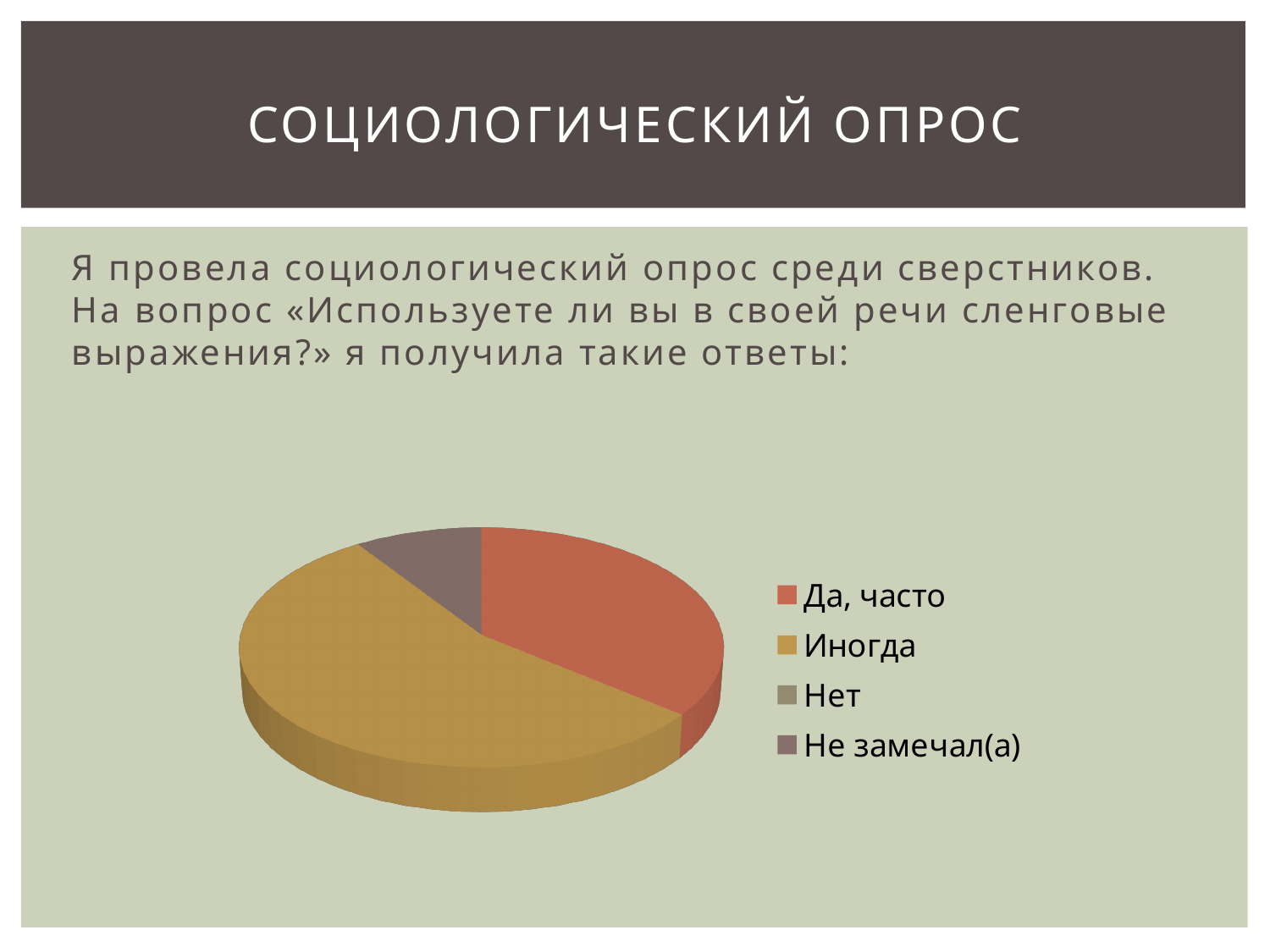
What kind of chart is shown on the slide? pie chart Which slice is larger, "Иногда" or "Не замечал(а)"? Иногда How many entries does the chart legend list? 4 Which slice is larger, "Да, часто" or "Иногда"? Иногда Which legend entry is shown in gold/yellow? Иногда Which category has the largest slice of the pie? Иногда Which slice is larger, "Да, часто" or "Не замечал(а)"? Да, часто What colour is the "Да, часто" slice in the pie chart? red